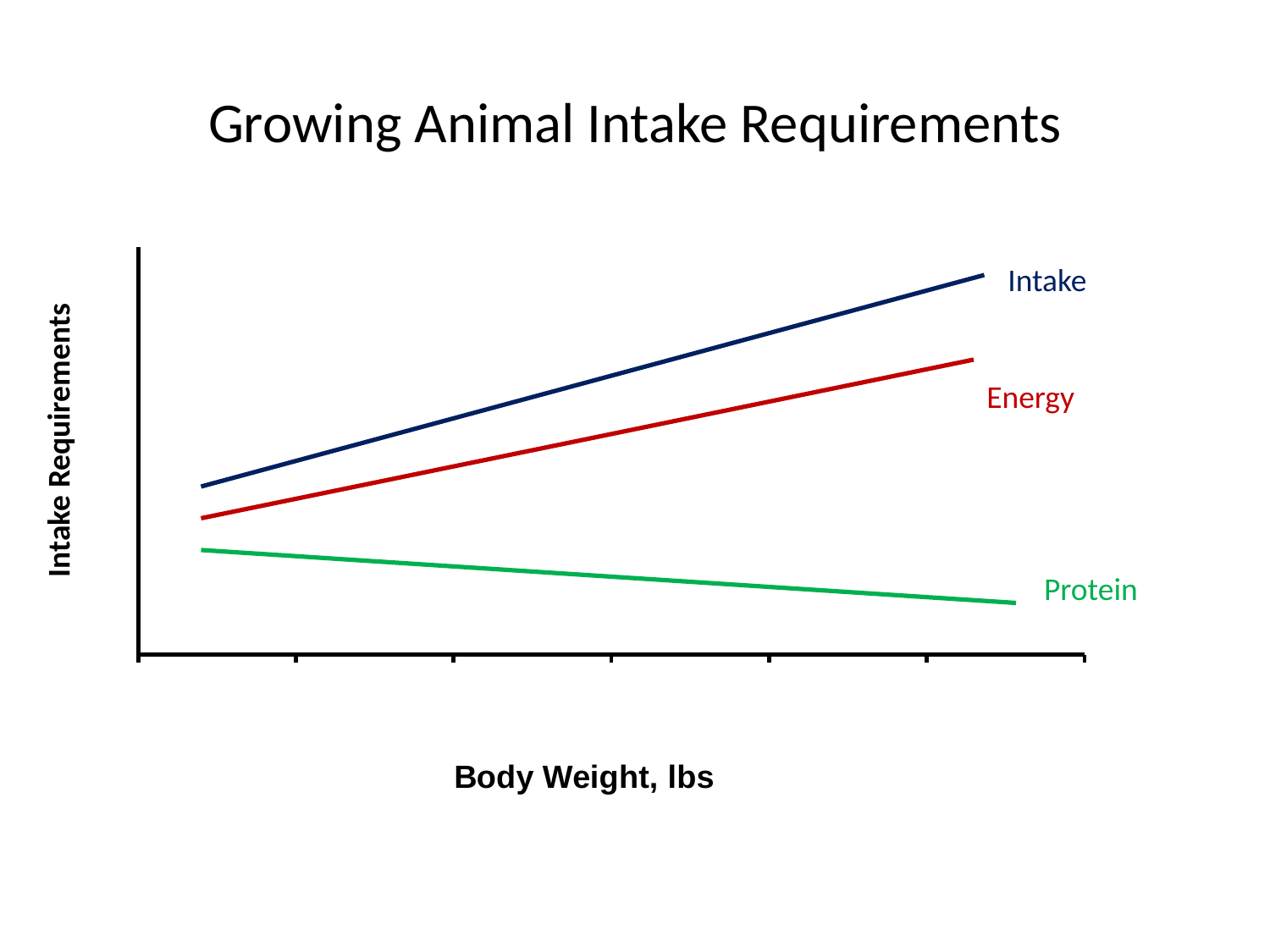
What is the title of the chart? Growing Animal Intake Requirements What kind of chart is shown on the slide? Line chart Does the Protein line rise or fall as body weight increases? Falls Does the Energy line rise or fall as body weight increases? Rises At the right end of the chart, which is higher, Energy or Protein? Energy Does the Intake line rise or fall as body weight increases? Rises How many lines (series) are plotted on the chart? 3 At the left end of the chart, which is higher, Intake or Energy? Intake What is the label on the x axis? Body Weight, lbs Which series has the lowest values across the chart? Protein Which series has the highest values across the chart? Intake